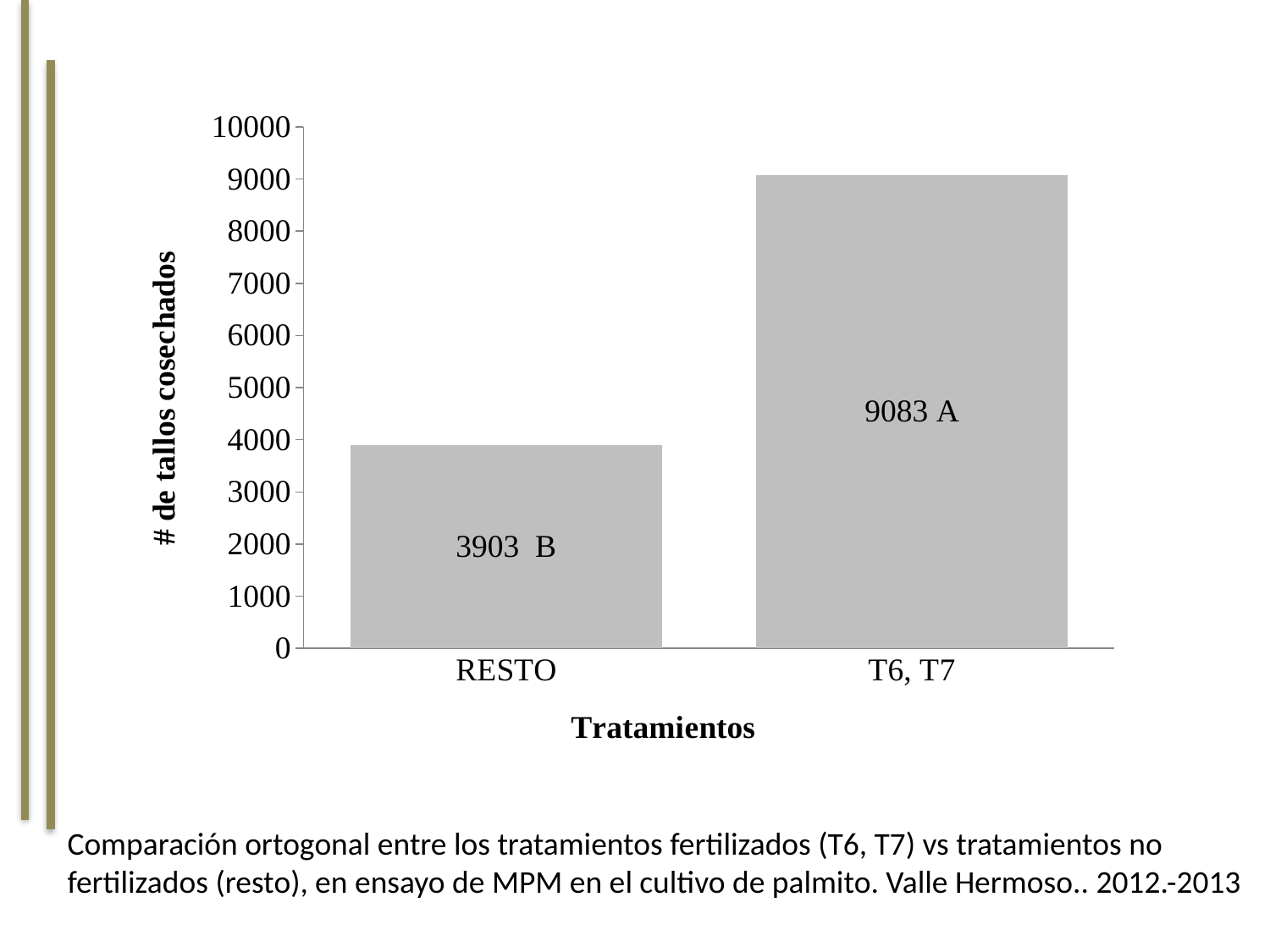
What is the label of the y axis? # de tallos cosechados Which is larger, the value for RESTO or the value for T6, T7? T6, T7 What is the value for T6, T7? 9083 What is the value for RESTO? 3903 Which treatment has the lowest number of harvested stems? RESTO Which treatment has the highest number of harvested stems? T6, T7 What is the label of the x axis? Tratamientos What kind of chart is shown on the slide? bar chart How many categories are shown on the x axis? 2 What is the difference between the values for T6, T7 and RESTO? 5180 Is the value for RESTO greater or less than 4000? less Is the value for T6, T7 greater or less than 9000? greater